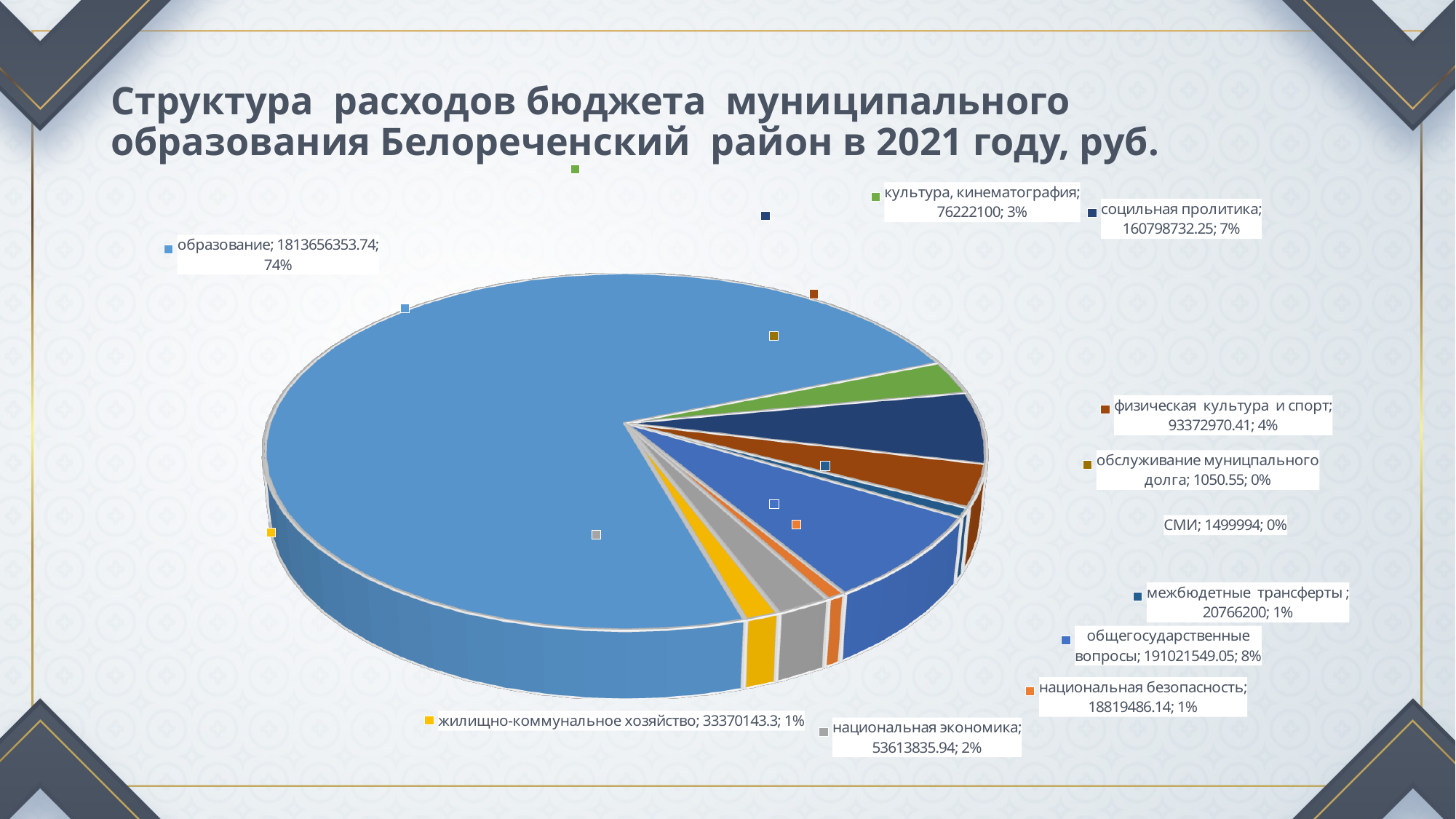
What kind of chart is shown on the slide? pie chart Which is larger: общегосударственные вопросы or социльная пролитика? общегосударственные вопросы How many categories (slices) does the pie chart show? 11 Which category has the smallest value? обслуживание муницпального долга What is the value for СМИ? 1499994 What is the value for образование? 1813656353.74 Which category has the largest share of the pie? образование What is the value for обслуживание муницпального долга? 1050.55 What share of the pie does образование represent? 74% What is the value for общегосударственные вопросы? 191021549.05 What is the difference between the values for физическая культура и спорт and культура, кинематография? 17150870.41 What share of the pie does социльная пролитика represent? 7%